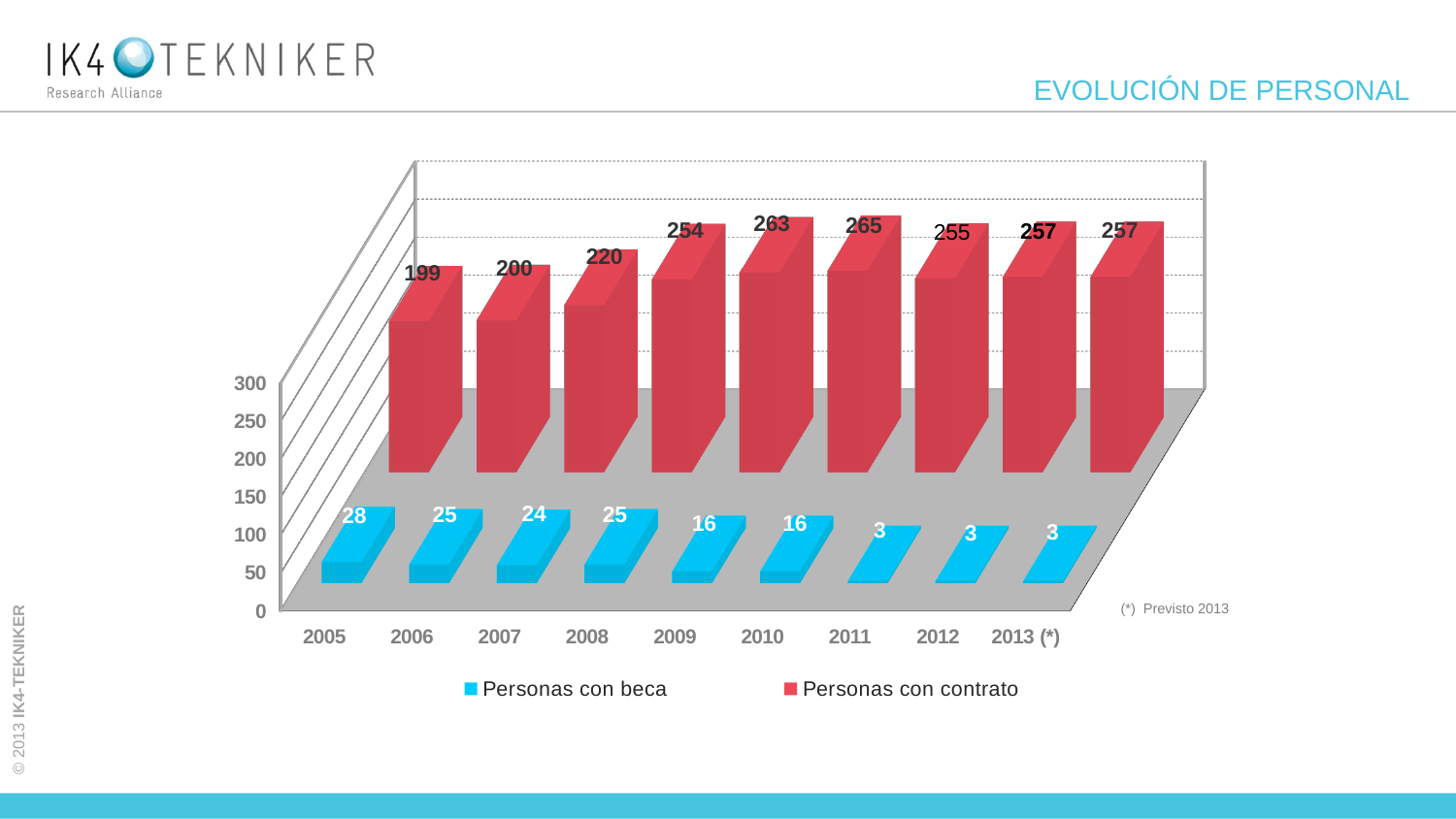
What is the value for Personas con contrato in 2010? 265 How many series does the legend list? 2 How many years are shown on the x axis? 9 What kind of chart is shown on the slide? Bar chart Does Personas con beca rise or fall from 2005 to 2013 (*)? Fall In which year is Personas con contrato highest? 2010 In which year is Personas con contrato lowest? 2005 Which is larger, Personas con beca in 2006 or in 2007? 2006 What is the value for Personas con beca in 2009? 16 What is the title of the slide containing the chart? EVOLUCIÓN DE PERSONAL What is the value for Personas con beca in 2005? 28 What is the difference between Personas con contrato in 2008 and in 2007? 34